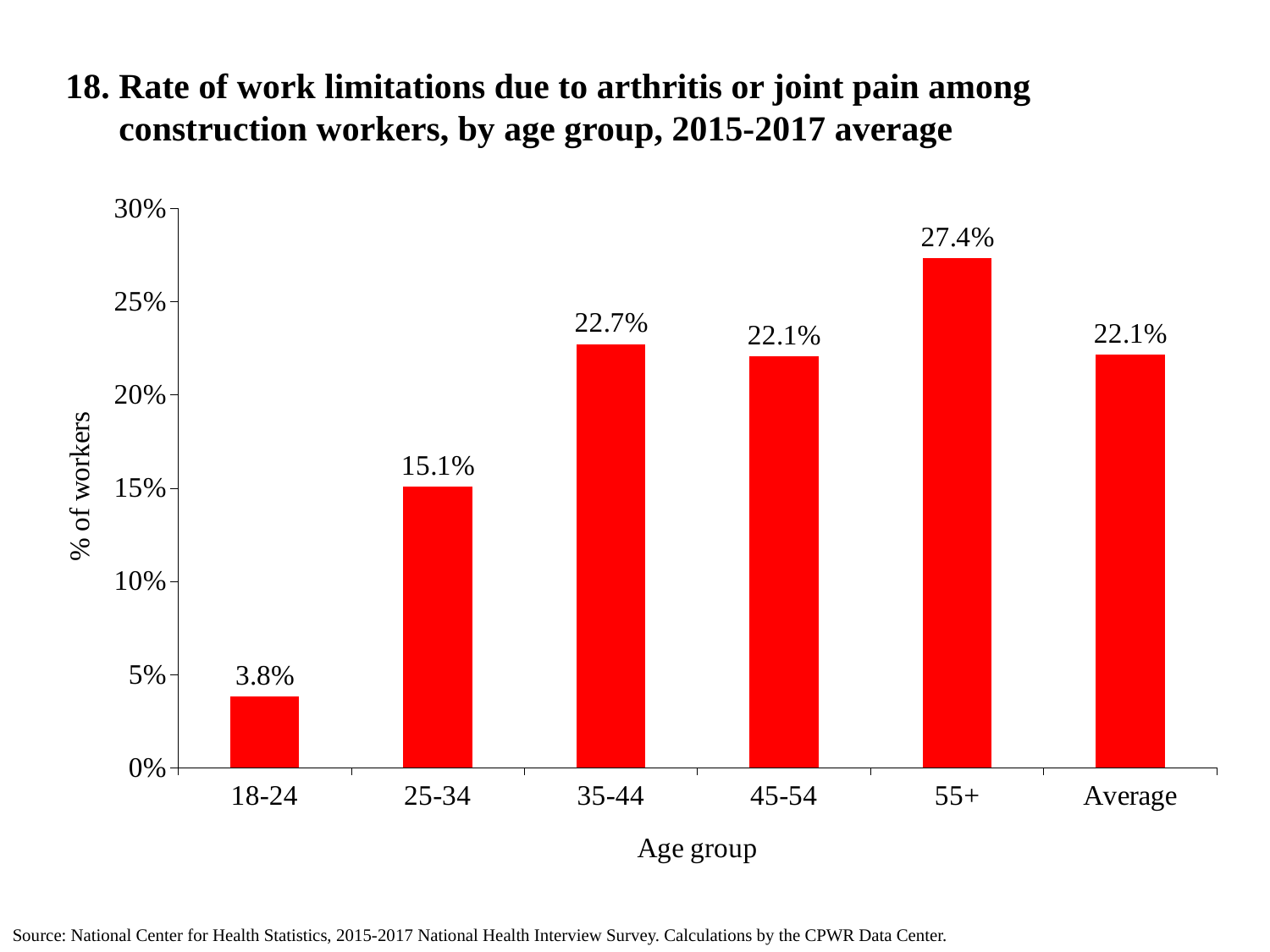
What kind of chart is shown on the slide? Bar chart Which has a higher rate, the 25-34 age group or the 45-54 age group? 45-54 Is the value for the 25-34 age group greater or less than 20%? less Which age group has the highest rate of work limitations? 55+ What is the rate of work limitations for the 55+ age group? 27.4% What is the value shown for the Average bar? 22.1% What is the difference between the rates for the 55+ and 18-24 age groups? 23.6% What is the label of the x axis? Age group What is the difference between the rates for the 35-44 and 25-34 age groups? 7.6% How many bars are shown in the chart? 6 What is the rate of work limitations for the 18-24 age group? 3.8% Which age group has the lowest rate of work limitations? 18-24